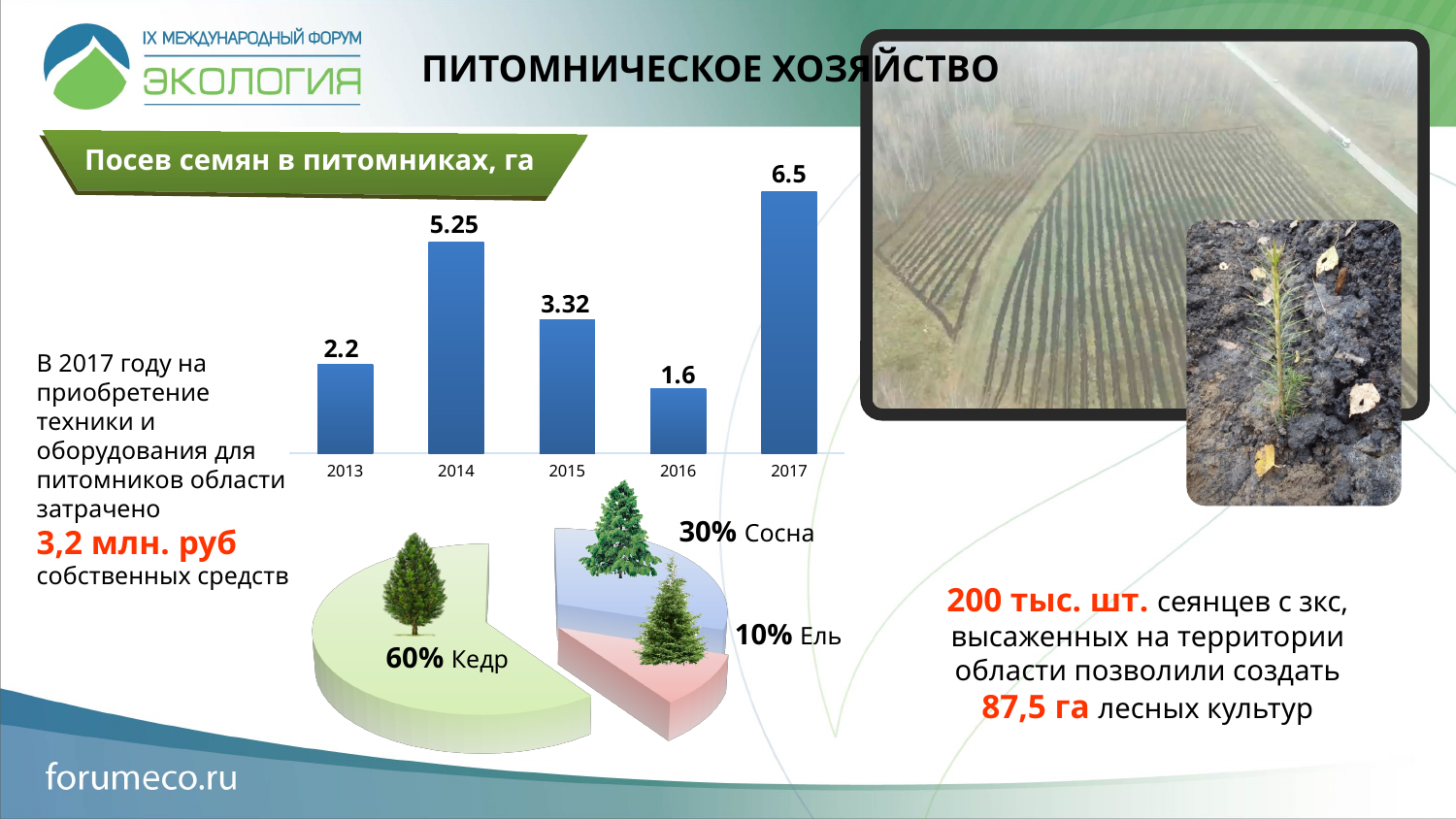
What kind of chart is 'Посев семян в питомниках, га'? bar chart In the bar chart 'Посев семян в питомниках, га', what is the value for 2016? 1.6 How many slices does the pie chart at the bottom of the slide have? 3 In the bar chart 'Посев семян в питомниках, га', what is the difference between the values for 2017 and 2013? 4.3 In the bar chart 'Посев семян в питомниках, га', which is larger: the value for 2015 or the value for 2014? 2014 In the bar chart 'Посев семян в питомниках, га', which year has the lowest value? 2016 In the pie chart at the bottom of the slide, which category has the largest share? Кедр How many years are shown in the bar chart 'Посев семян в питомниках, га'? 5 In the pie chart at the bottom of the slide, what share does Ель have? 10% In the bar chart 'Посев семян в питомниках, га', what is the value for 2014? 5.25 In the bar chart 'Посев семян в питомниках, га', which year has the highest value? 2017 In the pie chart at the bottom of the slide, what share does Кедр have? 60%